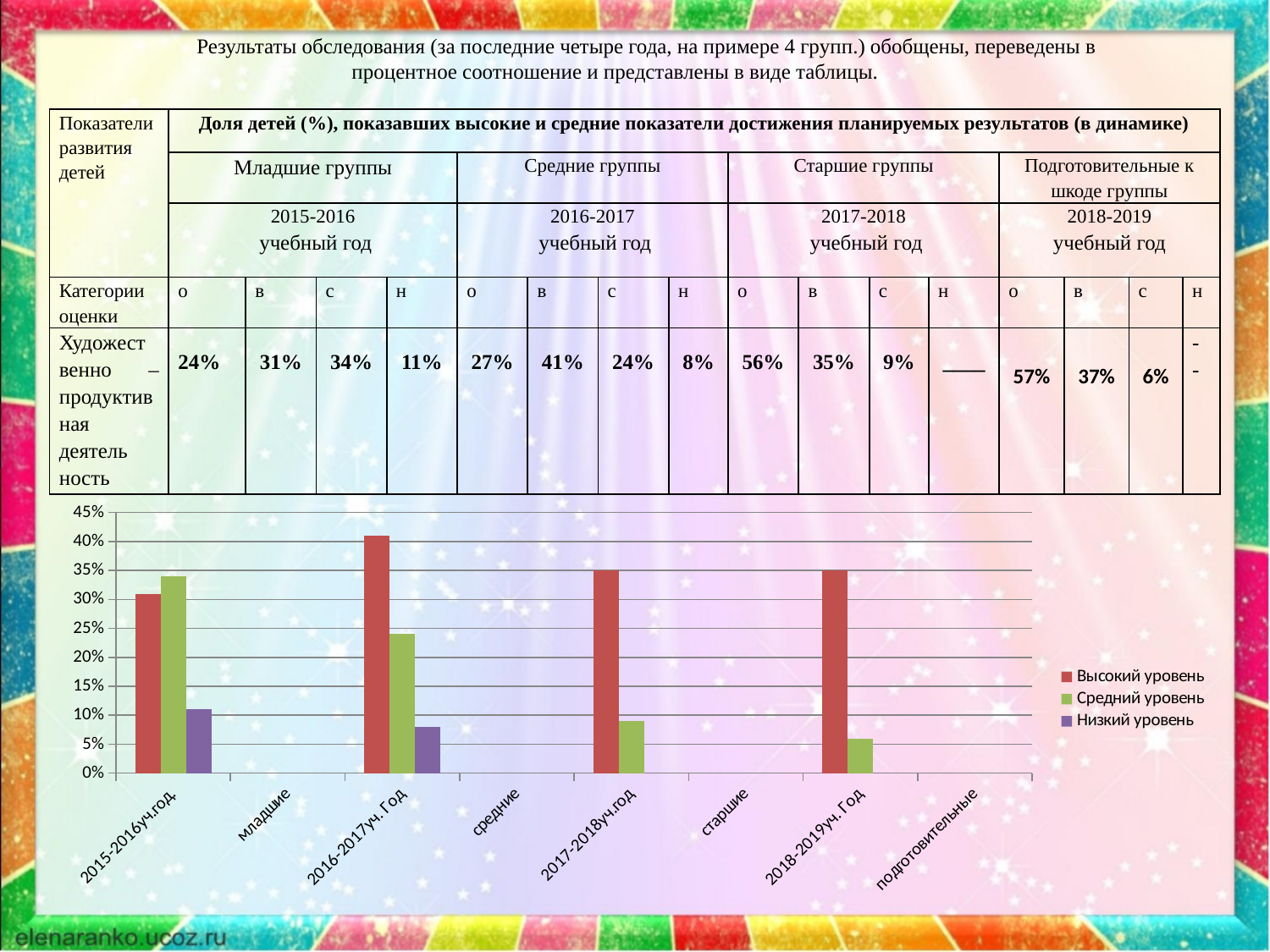
In the chart, is the Высокий уровень bar for 2016-2017уч. Год greater or less than 35%? greater How many category labels are shown along the x axis of the chart? 8 How many series does the chart legend list? 3 In the chart, for 2015-2016уч.год, which is larger: the Высокий уровень bar or the Средний уровень bar? Средний уровень In the chart, is the Средний уровень bar for 2018-2019уч. Год greater or less than 10%? less What colour represents Низкий уровень in the chart legend? purple Which category has the tallest Высокий уровень bar in the chart? 2016-2017уч. Год In the chart, which is larger: the Высокий уровень bar for 2015-2016уч.год or for 2016-2017уч. Год? 2016-2017уч. Год Which category has the shortest Средний уровень bar in the chart? 2018-2019уч. Год In the chart, is the Средний уровень bar for 2016-2017уч. Год greater or less than 20%? greater What kind of chart is shown below the table on the slide? bar chart